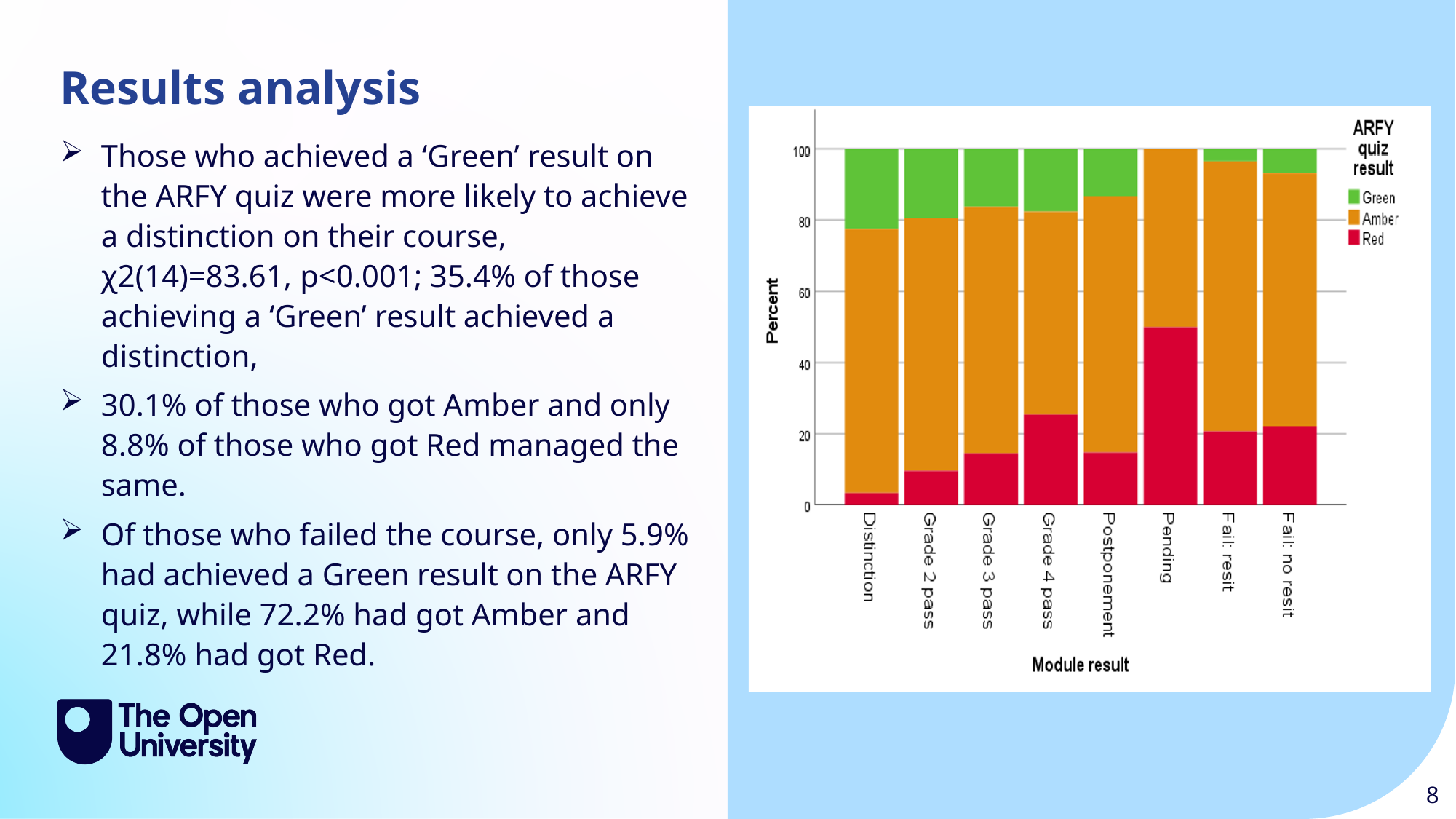
Is the Red percentage for Grade 4 pass greater or less than 20? greater What kind of chart is shown on the slide? Stacked bar chart What is the title of the chart's legend? ARFY quiz result Which has a larger Red segment: Pending or Grade 2 pass? Pending Which module result category has the largest Red segment? Pending Which module result category has the largest Green segment? Distinction Is the Red percentage for Pending greater or less than 40? greater Is the Red percentage for Distinction greater or less than 20? less Which module result category has the smallest Red segment? Distinction How many series does the chart's legend list? 3 What is the label on the chart's y axis? Percent How many module result categories are shown on the x axis of the chart? 8